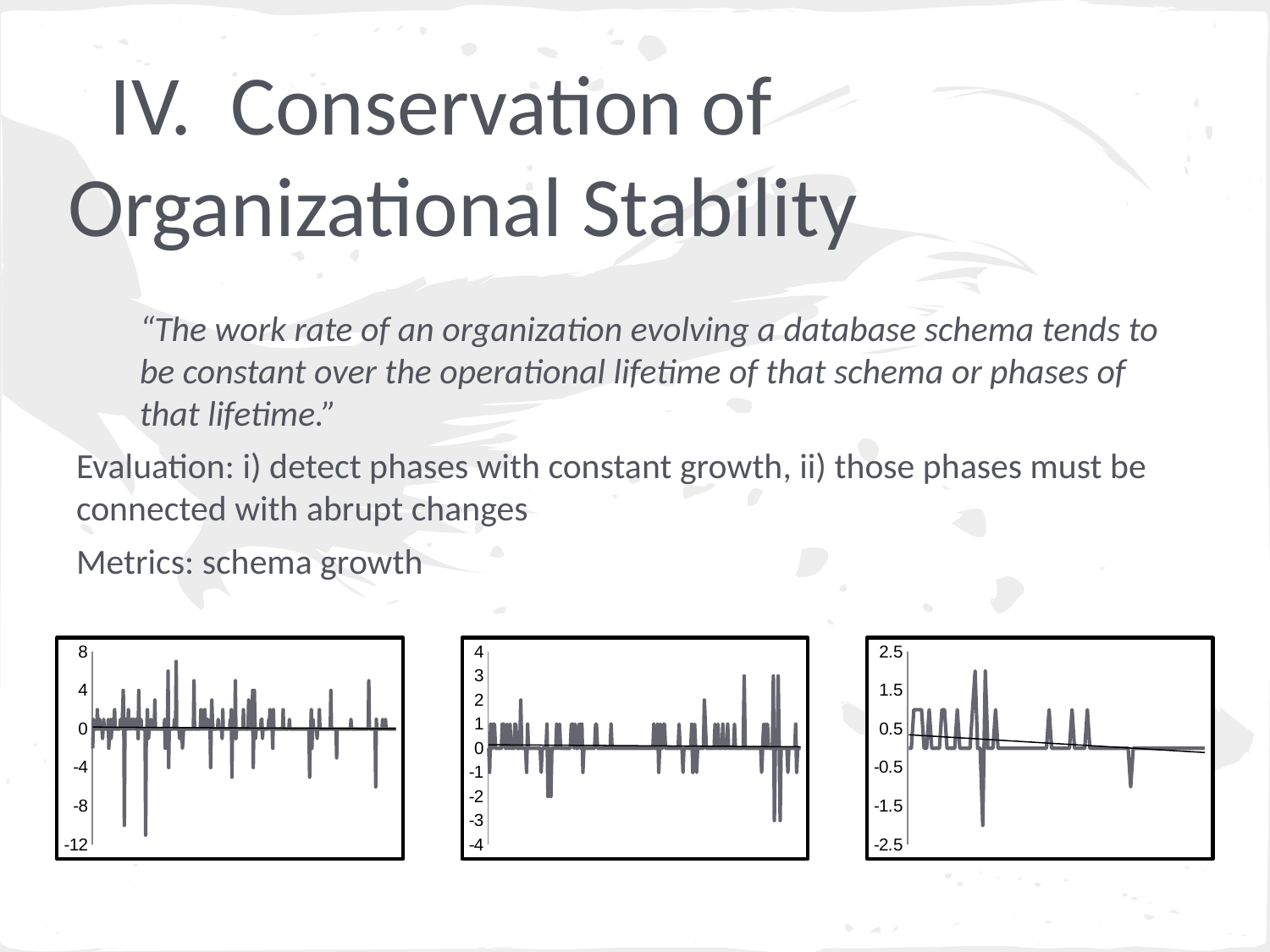
In the middle chart, is the lowest plotted value greater or less than -2? less In the rightmost chart, is the lowest plotted value greater or less than -1.5? less In the leftmost chart, is the highest plotted value greater or less than 4? greater What kind of chart is the rightmost chart at the bottom of the slide? line chart In the leftmost chart, what is the lowest value shown on the vertical axis? -12 How many charts are shown on the slide? 3 In the rightmost chart, does the straight trend line rise or fall from left to right? fall What kind of chart is the leftmost chart at the bottom of the slide? line chart In the leftmost chart, what is the highest value shown on the vertical axis? 8